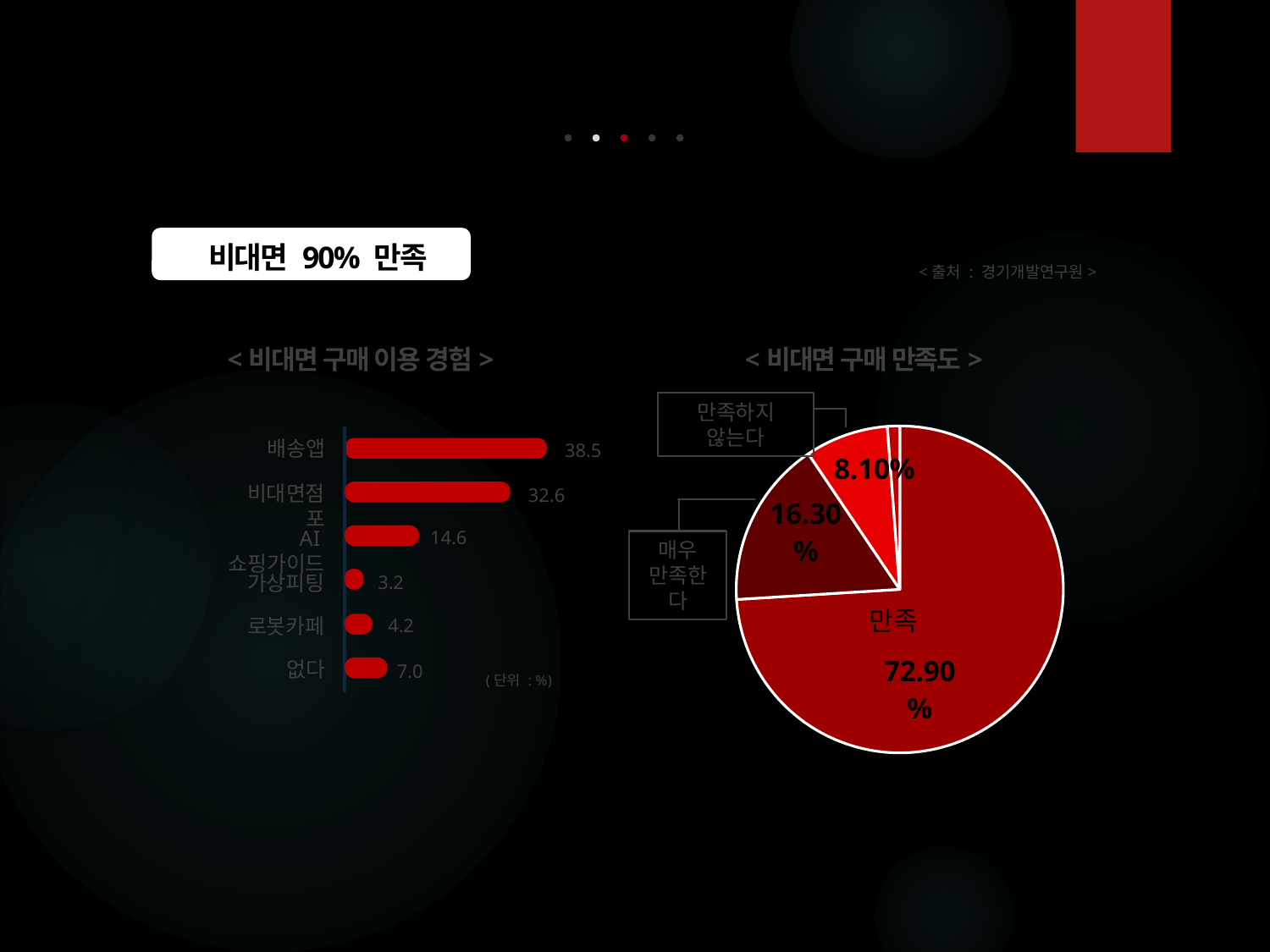
What kind of chart is '< 비대면 구매 이용 경험 >'? bar chart How many categories are shown in the bar chart '< 비대면 구매 이용 경험 >'? 6 In the bar chart '< 비대면 구매 이용 경험 >', what is the value for 배송앱? 38.5 What kind of chart is '< 비대면 구매 만족도 >'? pie chart In the bar chart '< 비대면 구매 이용 경험 >', what is the value for 로봇카페? 4.2 In the bar chart '< 비대면 구매 이용 경험 >', which category has the lowest value? 가상피팅 In the pie chart '< 비대면 구매 만족도 >', which slice is the largest? 만족 In the pie chart '< 비대면 구매 만족도 >', what share does 만족 have? 72.90% In the bar chart '< 비대면 구매 이용 경험 >', which is larger, the value for 없다 or the value for 로봇카페? 없다 In the bar chart '< 비대면 구매 이용 경험 >', which category has the highest value? 배송앱 In the bar chart '< 비대면 구매 이용 경험 >', what is the difference between the values for 배송앱 and 비대면점포? 5.9 In the pie chart '< 비대면 구매 만족도 >', what share does 만족하지 않는다 have? 8.10%